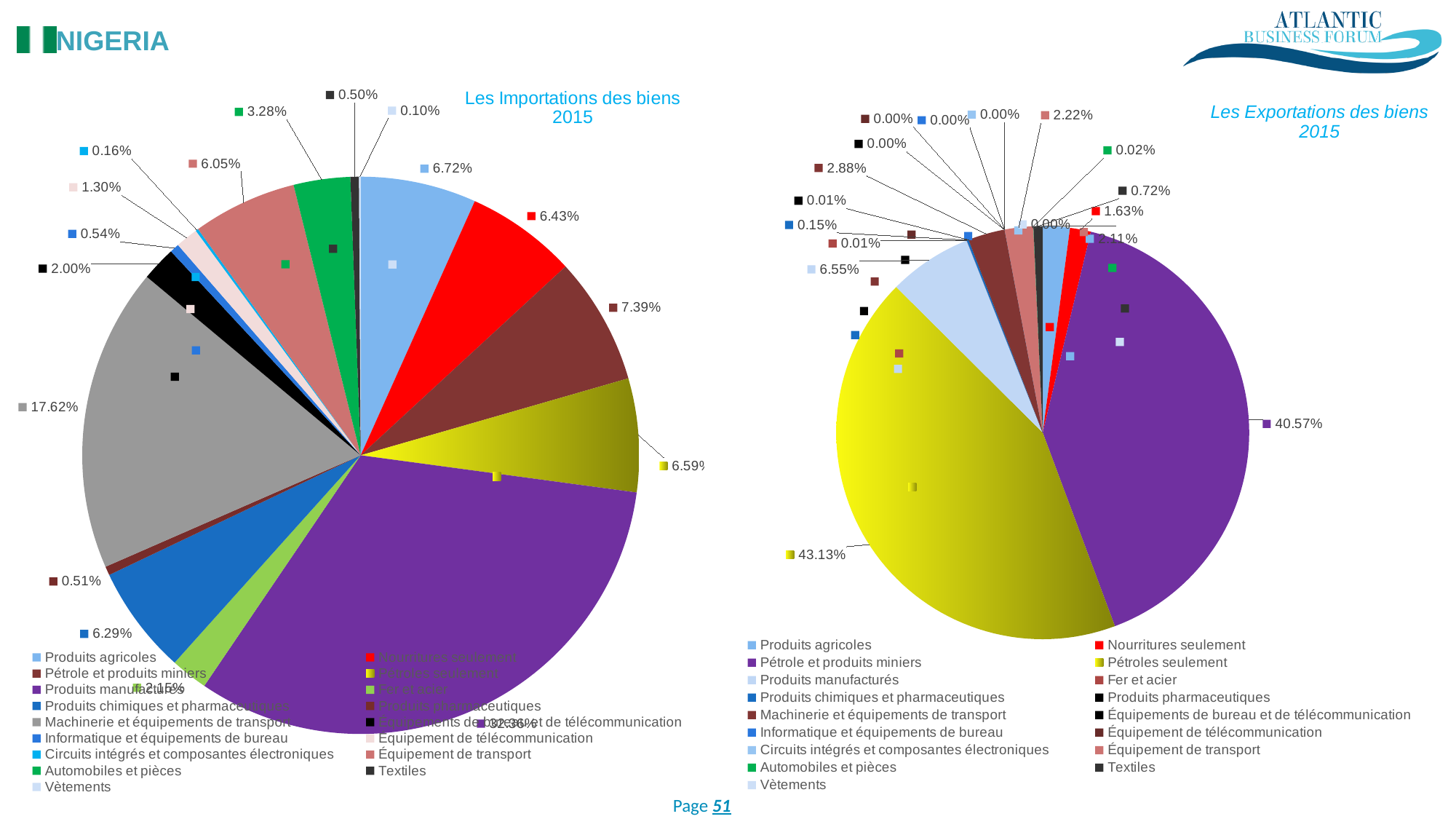
In the 'Les Importations des biens 2015' pie chart, what share is shown for Produits manufacturés? 32.36% In the 'Les Exportations des biens 2015' pie chart, what share is shown for Pétroles seulement? 43.13% In the 'Les Importations des biens 2015' pie chart, which category has the largest share? Produits manufacturés In the 'Les Exportations des biens 2015' pie chart, what share is shown for Produits manufacturés? 6.55% In the 'Les Importations des biens 2015' pie chart, what is the difference between the shares of Produits manufacturés and Machinerie et équipements de transport? 14.74% What type of chart is used for 'Les Importations des biens 2015'? Pie chart In the 'Les Exportations des biens 2015' pie chart, what is the difference between the shares of Pétroles seulement and Produits manufacturés? 36.58% How many categories does the legend of the 'Les Exportations des biens 2015' chart list? 17 In the 'Les Importations des biens 2015' pie chart, what share is shown for Machinerie et équipements de transport? 17.62% In the 'Les Exportations des biens 2015' pie chart, which is larger: Pétroles seulement or Pétrole et produits miniers? Pétroles seulement In the 'Les Importations des biens 2015' pie chart, what share is shown for Produits agricoles? 6.72% In the 'Les Exportations des biens 2015' pie chart, what share is shown for Pétrole et produits miniers? 40.57%